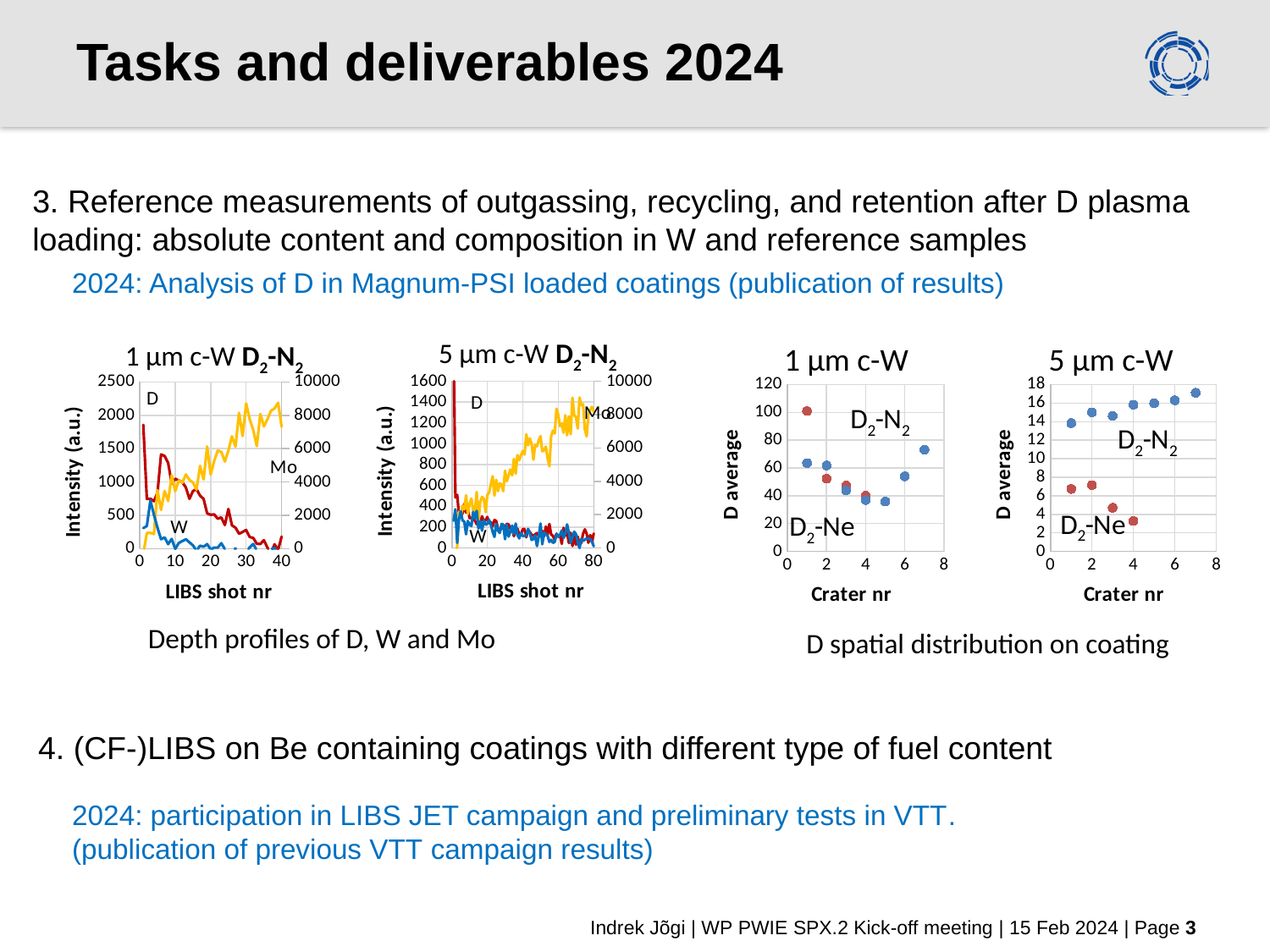
In the "5 µm c-W" D average chart, is the D2-N2 value at crater 7 greater or less than 16? greater What kind of chart is the "1 µm c-W D2-N2" chart? line chart What is the x-axis label of the "5 µm c-W" D average chart? Crater nr In the "5 µm c-W D2-N2" chart, does the Mo intensity rise or fall as the LIBS shot number increases? rises In the "5 µm c-W" D average chart, which series has the larger value at crater 2, D2-N2 or D2-Ne? D2-N2 What kind of chart is the "1 µm c-W" D average chart? scatter chart In the "1 µm c-W" D average chart, is the D2-Ne value at crater 1 greater or less than 80? greater In the "1 µm c-W D2-N2" chart, does the D intensity rise or fall as the LIBS shot number increases? falls In the "1 µm c-W" D average chart, which series has the larger value at crater 1, D2-N2 or D2-Ne? D2-Ne In the "5 µm c-W" D average chart, does the D2-N2 series rise or fall as the crater number increases? rises In the "5 µm c-W" D average chart, is the D2-Ne value at crater 4 greater or less than 6? less In the "1 µm c-W" D average chart, how many D2-Ne points are plotted? 4